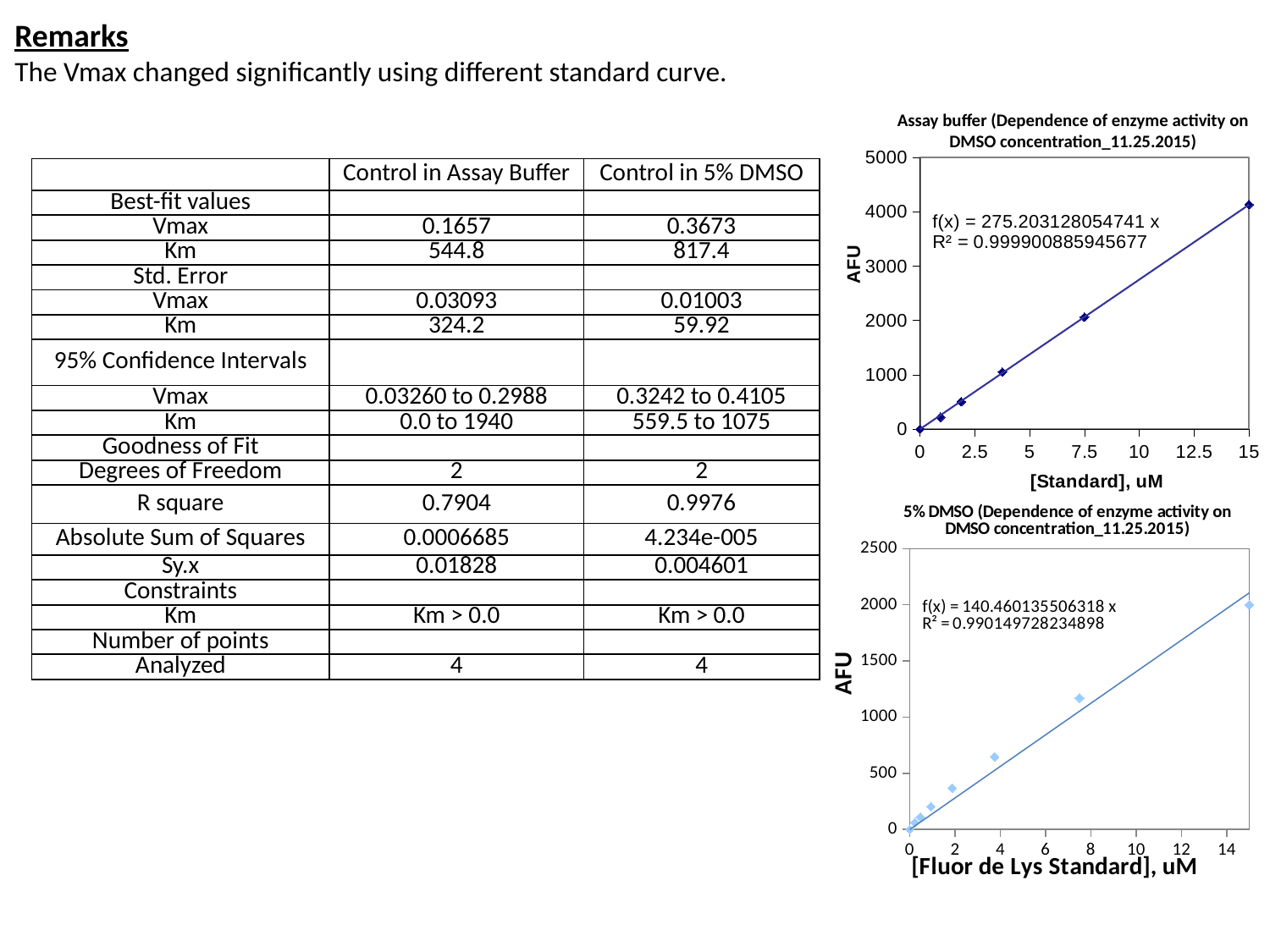
In the bottom chart (5% DMSO), is the AFU value at about 3.75 uM greater or less than 500? greater What kind of chart is the top chart titled 'Assay buffer (Dependence of enzyme activity on DMSO concentration_11.25.2015)'? Scatter chart with a trendline In the top chart (Assay buffer), do the AFU values rise or fall as the standard concentration increases? Rise In the top chart (Assay buffer), what is the trendline equation shown? f(x) = 275.203128054741 x In the bottom chart (5% DMSO), is the AFU value at about 7.5 uM greater or less than 1000? greater In the bottom chart (5% DMSO), what R² value is shown for the trendline? 0.990149728234898 How many data points are plotted in the top chart (Assay buffer)? 6 In the bottom chart (5% DMSO), is the AFU value at about 15 uM greater or less than 2500? less Which chart has the larger trendline slope, the top chart (Assay buffer) or the bottom chart (5% DMSO)? The top chart (Assay buffer) In the bottom chart (5% DMSO), do the AFU values rise or fall as the Fluor de Lys standard concentration increases? Rise